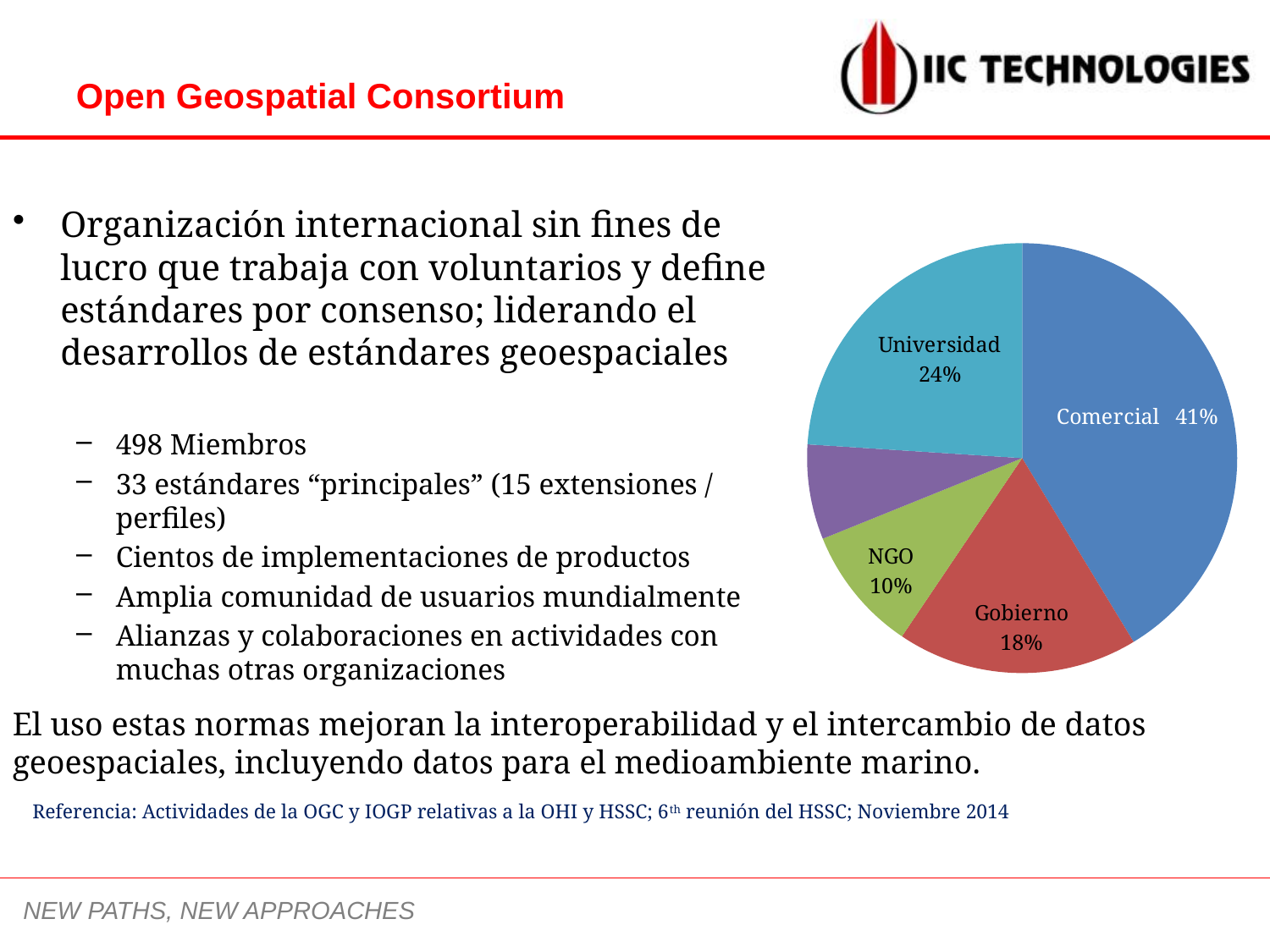
Which labeled category has the largest share of the pie? Comercial What share of the pie does Comercial represent? 41% What colour is the Comercial slice of the pie? blue What share of the pie does Universidad represent? 24% What share of the pie does NGO represent? 10% How many slices does the pie chart have? 5 Which labeled category has the smallest share of the pie? NGO What is the difference in percentage points between the Comercial and Universidad shares? 17 Which is larger, the Universidad share or the Gobierno share? Universidad What kind of chart is shown on the slide? pie chart What is the difference in percentage points between the Gobierno and NGO shares? 8 What share of the pie does Gobierno represent? 18%